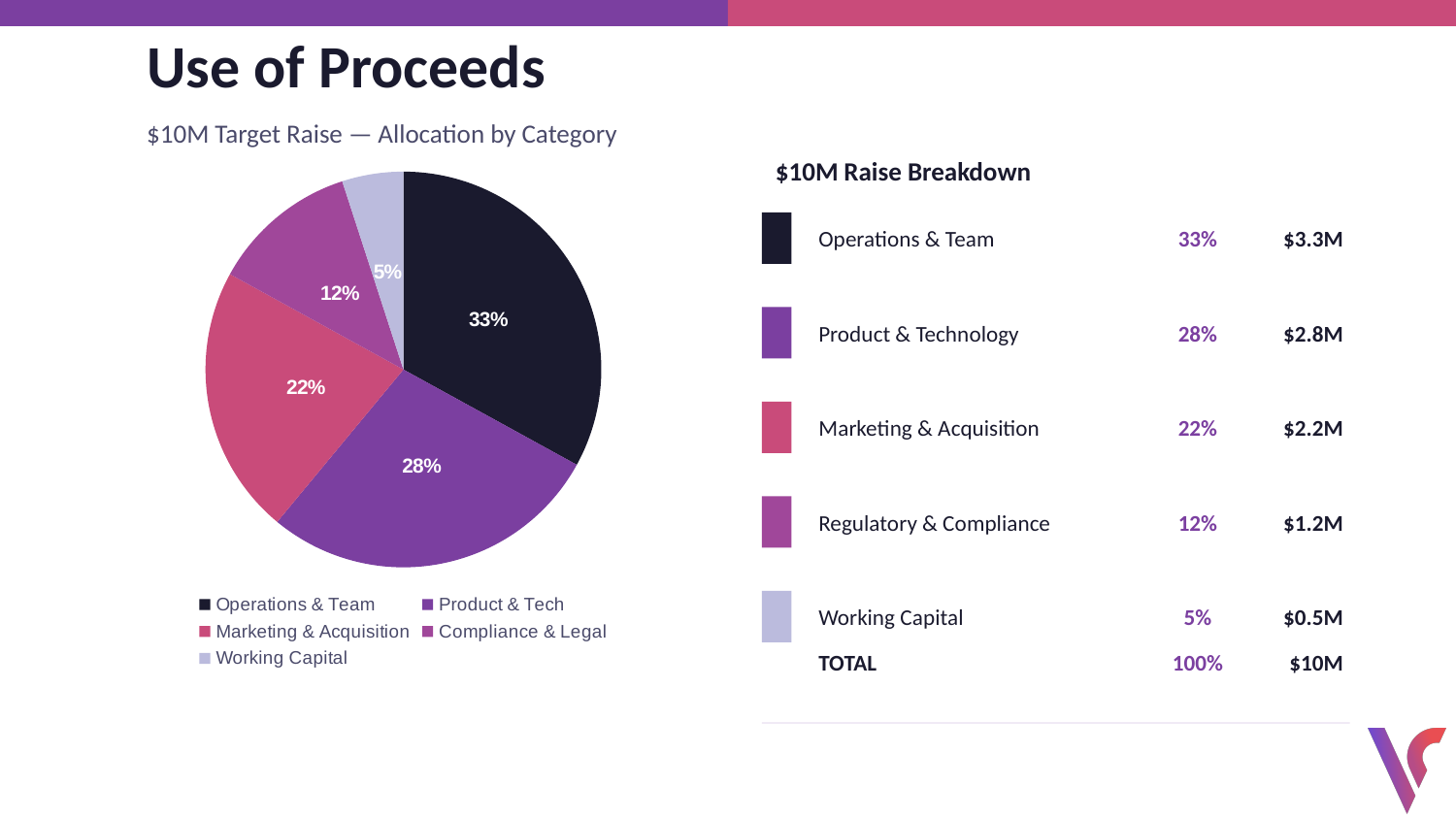
What colour is the Operations & Team slice in the pie chart? black Which is larger, the slice for Marketing & Acquisition or the slice for Compliance & Legal? Marketing & Acquisition What is the difference in percentage points between Operations & Team and Product & Tech? 5% What share of the pie does Operations & Team represent? 33% What kind of chart is shown on the slide? pie chart What is the value shown for Product & Tech in the pie chart? 28% What is the value shown for Compliance & Legal in the pie chart? 12% Which category has the smallest slice of the pie? Working Capital What is the value shown for Working Capital in the pie chart? 5% What is the value shown for Marketing & Acquisition in the pie chart? 22% How many categories does the pie chart show? 5 Which category has the largest slice of the pie? Operations & Team